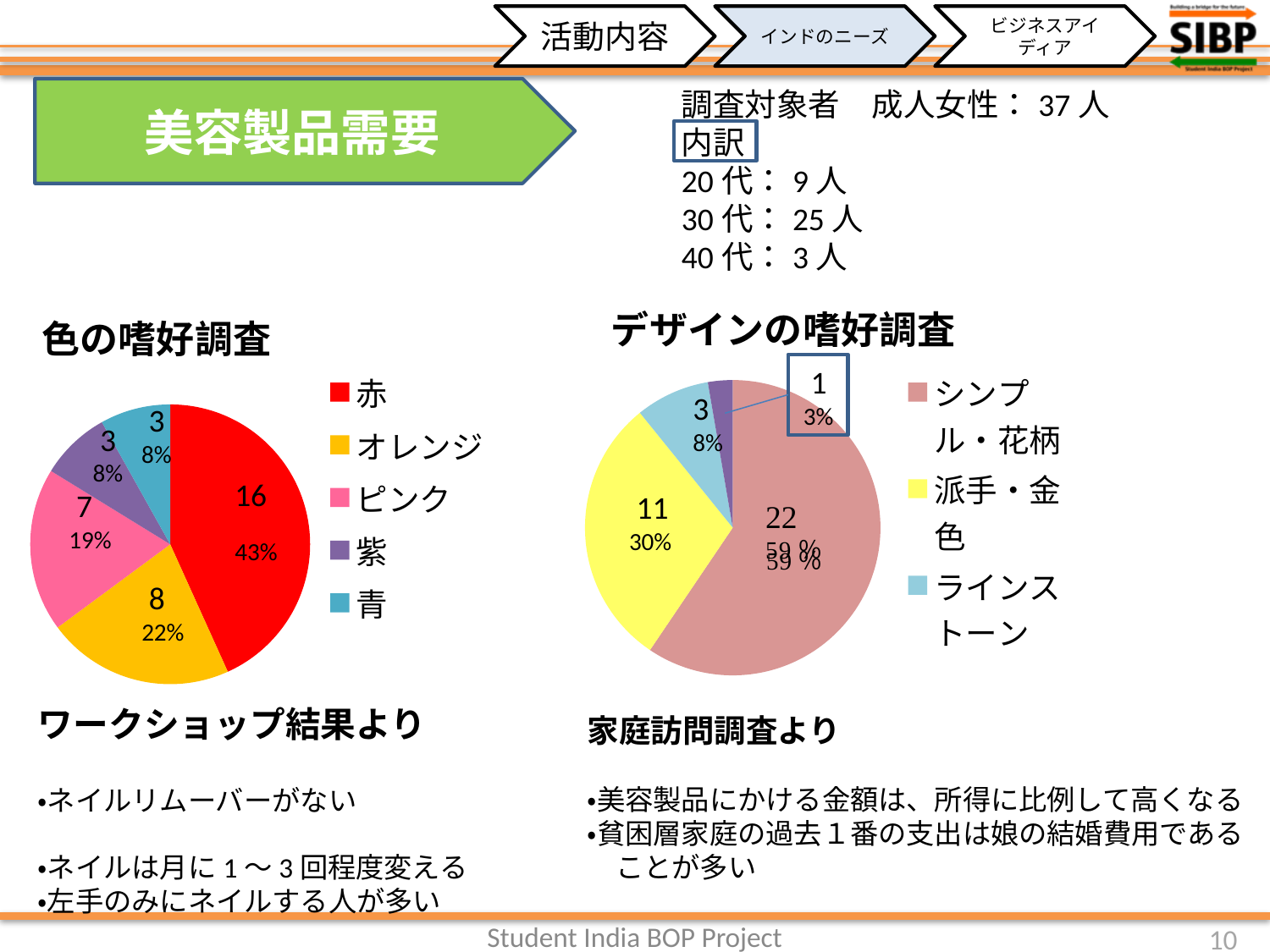
In the 色の嗜好調査 chart, what percentage share does オレンジ have? 22% What kind of chart is the 色の嗜好調査 chart? pie chart In the 色の嗜好調査 chart, which category has the highest value? 赤 In the デザインの嗜好調査 chart, what is the difference between the values for シンプル・花柄 and 派手・金色? 11 How many entries does the legend of the 色の嗜好調査 chart list? 5 In the デザインの嗜好調査 chart, what is the value for 派手・金色? 11 In the デザインの嗜好調査 chart, which category has the highest value? シンプル・花柄 In the デザインの嗜好調査 chart, what percentage share does シンプル・花柄 have? 59% In the 色の嗜好調査 chart, what is the difference between the values for 赤 and ピンク? 9 In the 色の嗜好調査 chart, what is the value for 赤? 16 In the 色の嗜好調査 chart, which is larger, オレンジ or ピンク? オレンジ In the デザインの嗜好調査 chart, what percentage share does ラインストーン have? 8%